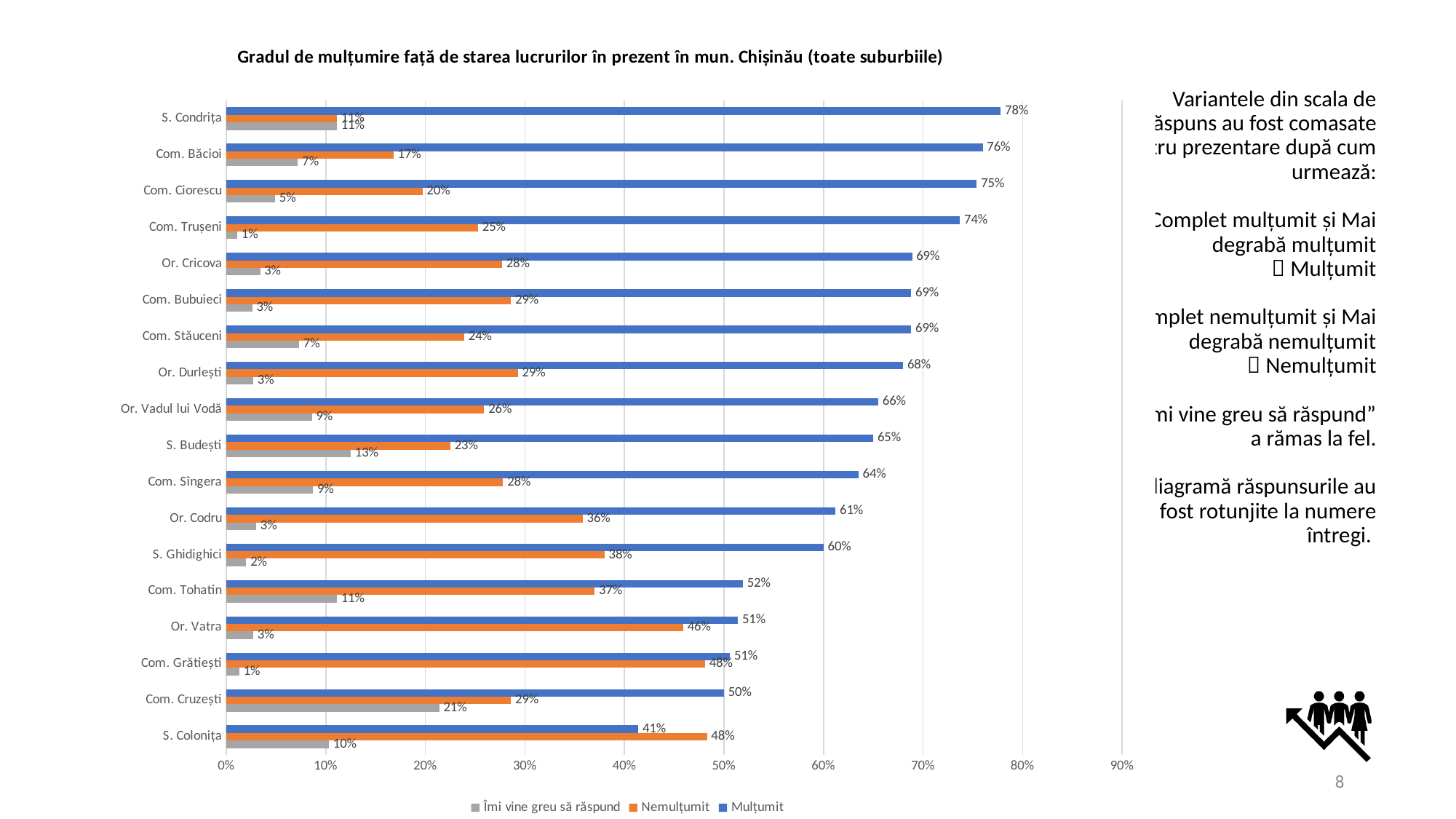
What is the Nemulțumit value for Or. Codru? 36% How many series does the legend list? 3 What is the Mulțumit value for S. Condrița? 78% Is the Mulțumit value for Or. Vatra greater or less than 60%? less What is the difference between the Mulțumit values of Com. Băcioi and Com. Tohatin? 24% What is the 'Îmi vine greu să răspund' value for Com. Cruzești? 21% What type of chart is shown on the slide? bar chart Which locality has the lowest Mulțumit value? S. Colonița How many localities (categories) are shown in the chart? 18 Which is larger for S. Colonița: the Mulțumit value or the Nemulțumit value? Nemulțumit Which locality has the highest Mulțumit value? S. Condrița What is the title of the chart? Gradul de mulțumire față de starea lucrurilor în prezent în mun. Chișinău (toate suburbiile)